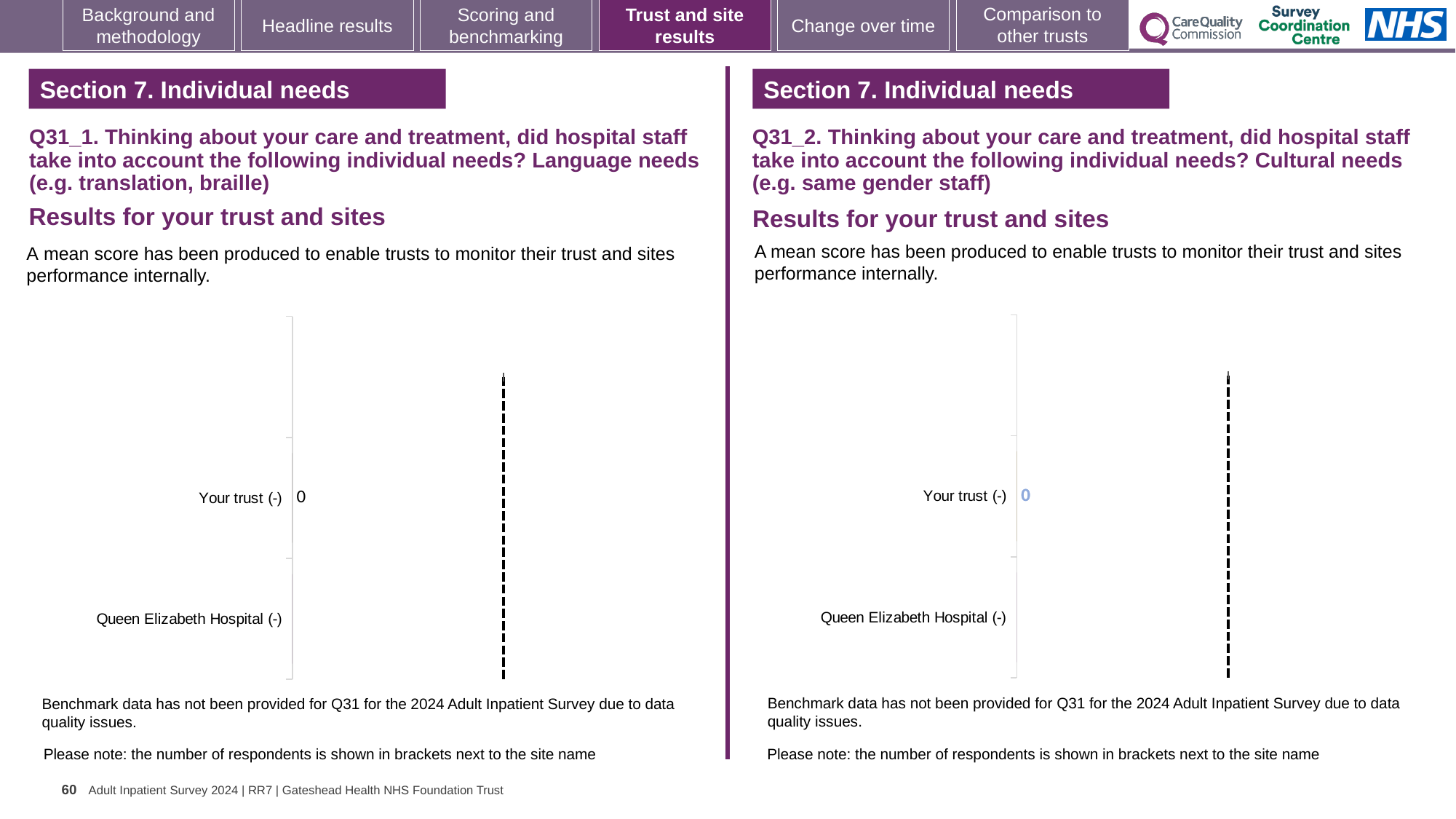
In the left chart (Q31_1, Language needs), which site is listed below Your trust on the y axis? Queen Elizabeth Hospital (-) In the right chart (Q31_2, Cultural needs), what value is shown for Your trust? 0 How many categories are listed on the y axis of the right chart (Q31_2, Cultural needs)? 2 In the right chart (Q31_2, Cultural needs), which category has a printed data label? Your trust (-) What kind of chart is the left chart (Q31_1, Language needs)? Bar chart How many categories are listed on the y axis of the left chart (Q31_1, Language needs)? 2 In the left chart (Q31_1, Language needs), what value is shown for Your trust? 0 What kind of chart is the right chart (Q31_2, Cultural needs)? Bar chart